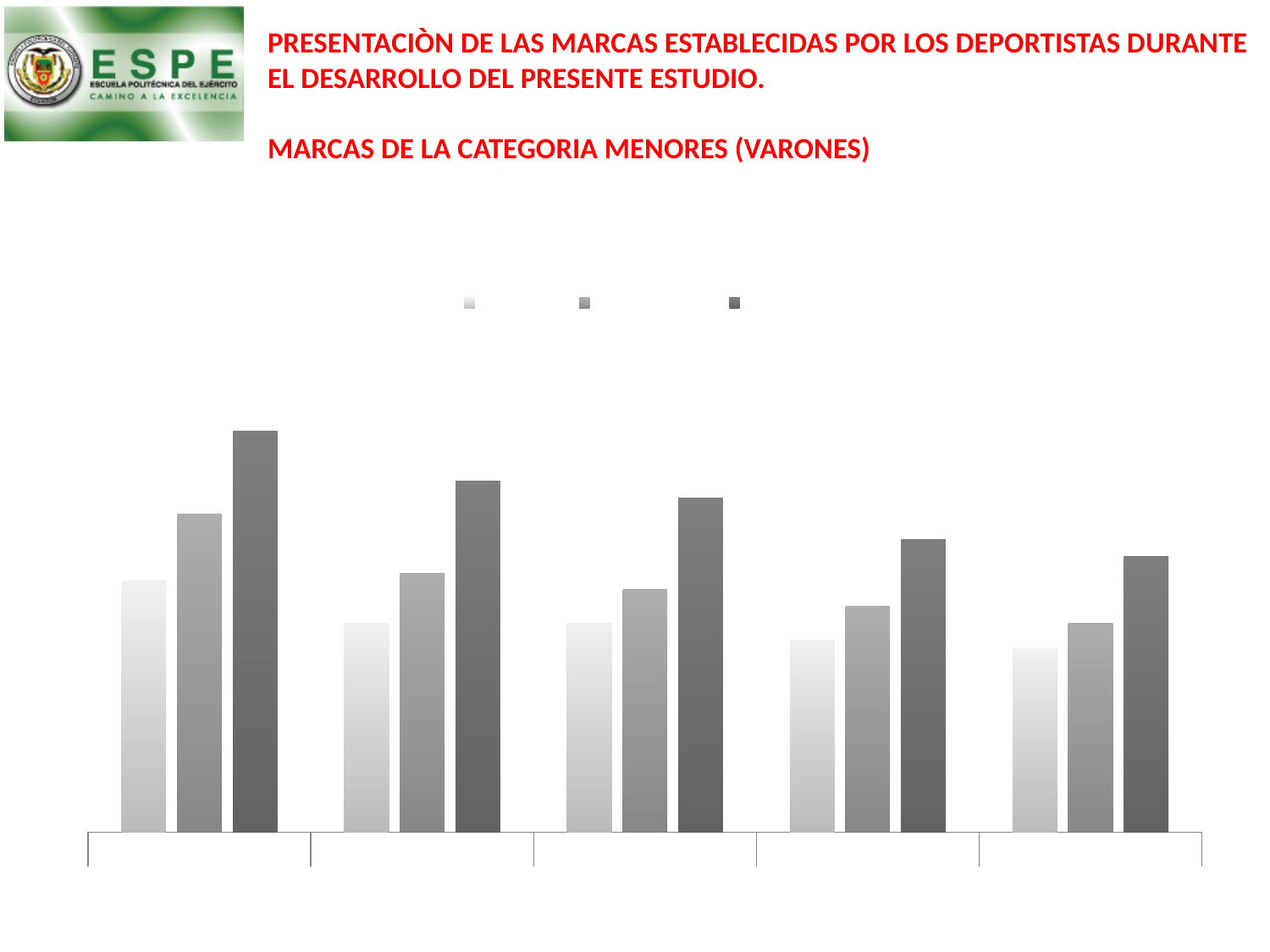
Which group of bars, counted from the left, contains the tallest bar on the chart? the first (leftmost) group How many bars are plotted in total on the chart? 15 What kind of chart is shown on the slide? bar chart Within each group, is the darkest bar taller or shorter than the lightest bar? taller How many series does the legend show? 3 Does the chart display any numeric axis labels or data labels? no How many groups of bars (categories) are plotted along the x axis? 5 Which group of bars, counted from the left, contains the shortest bar on the chart? the fifth (rightmost) group What colours are used for the three series in the chart? light grey, medium grey and dark grey